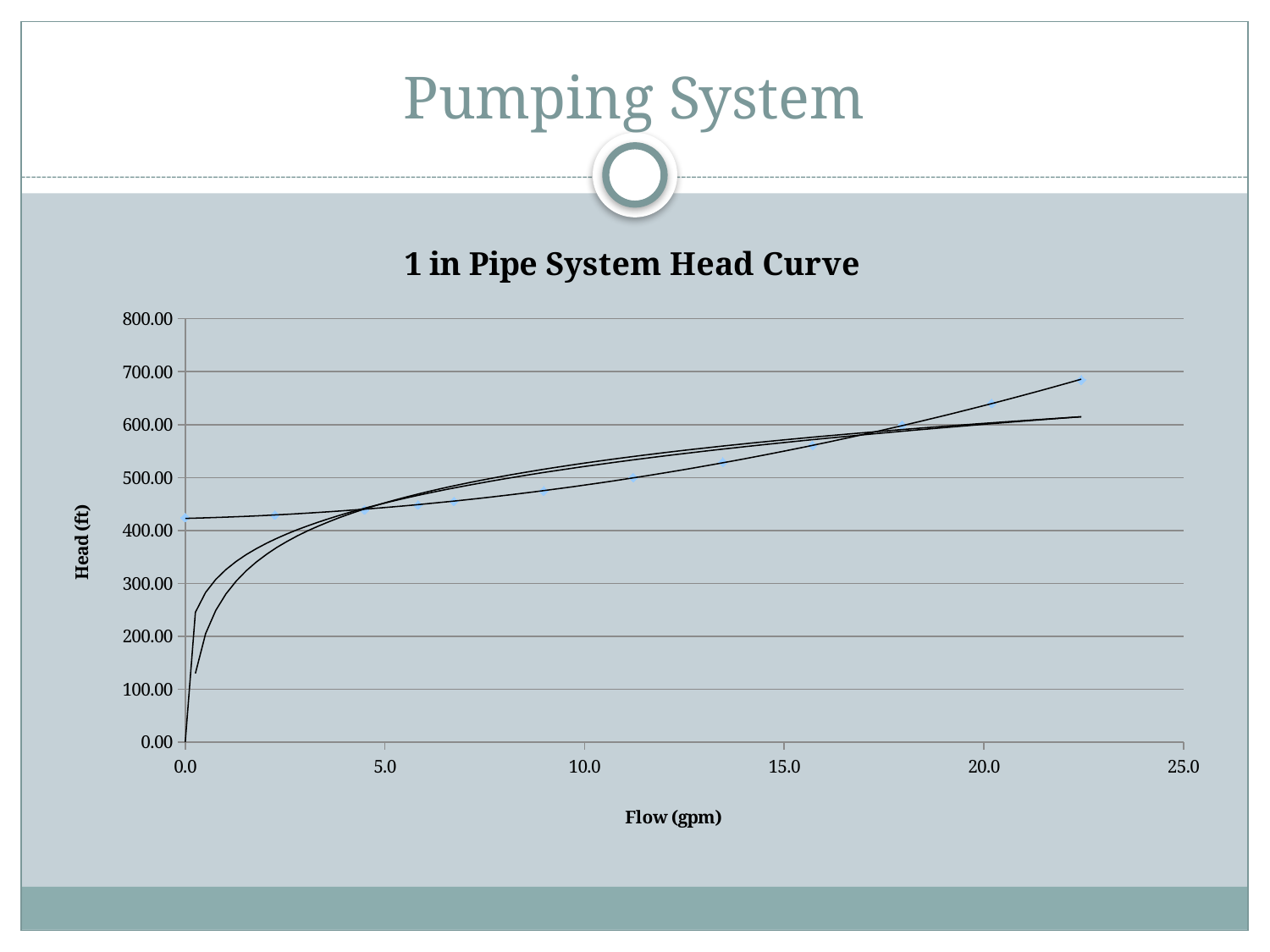
Is the head value of the marked curve at a flow of 20.0 gpm greater or less than 600? greater Is the head value of the marked curve at a flow of 5.0 gpm greater or less than 400? greater How many curves are plotted on the chart? 3 Is the head value of the marked curve at a flow of 10.0 gpm greater or less than 500? less Does the head value rise or fall as flow increases along the x axis? rise Which flow value has the higher head on the marked curve, 5.0 gpm or 20.0 gpm? 20.0 gpm What is the title of the chart? 1 in Pipe System Head Curve What kind of chart is shown on the slide? line chart At which end of the flow axis does the marked curve reach its lowest head value? 0.0 gpm